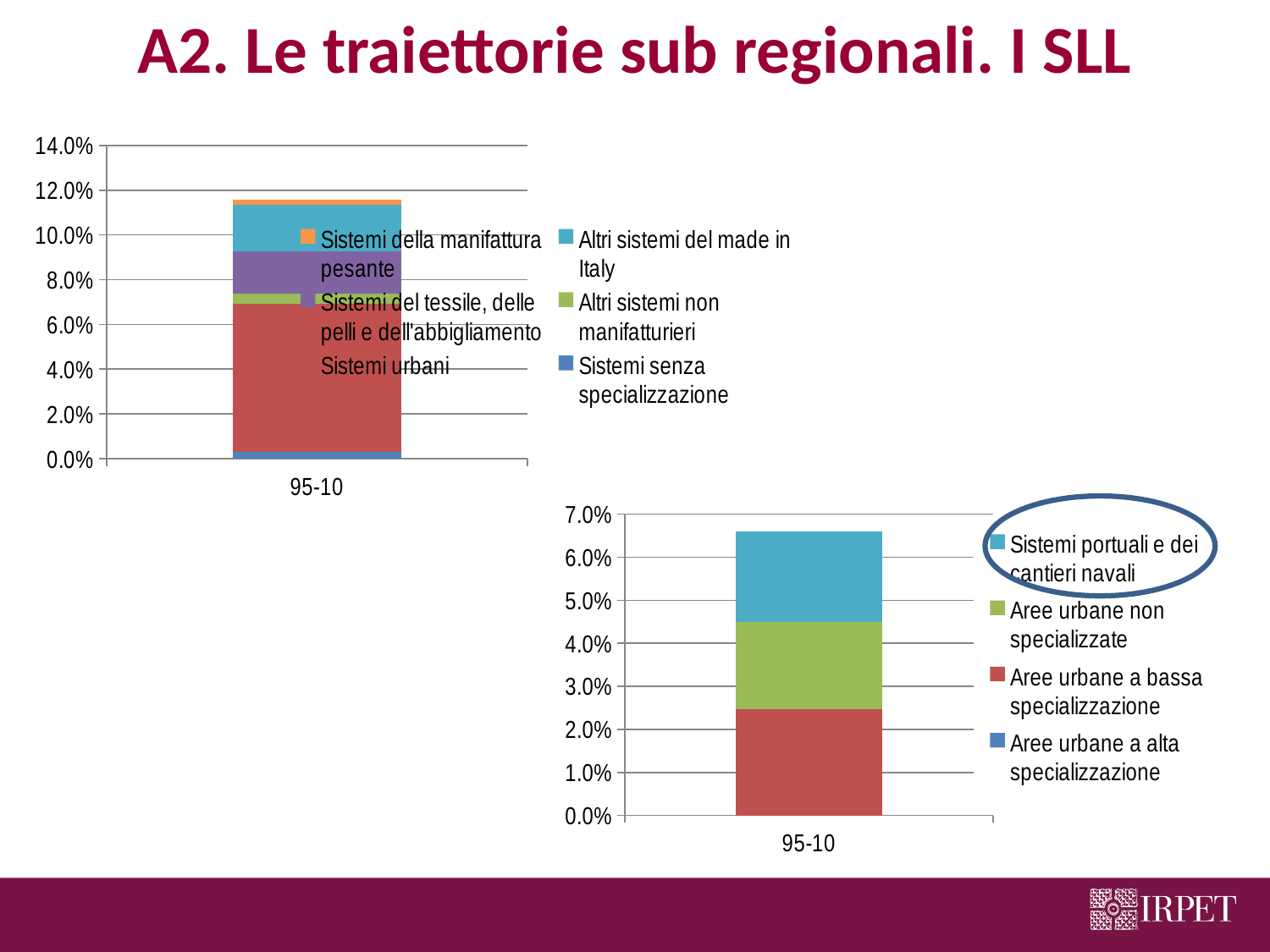
In the bottom-right chart, is the total height of the stacked bar greater or less than 6.0%? greater How many categories are shown on the x axis of the top-left chart? 1 How many series does the legend of the top-left chart list? 6 What kind of chart is the top-left chart on the slide? Stacked bar chart In the top-left chart, is the segment for Sistemi urbani greater or less than 6.0%? greater How many series does the legend of the bottom-right chart list? 4 What is the category label on the x axis of the bottom-right chart? 95-10 What kind of chart is the bottom-right chart on the slide? Stacked bar chart In the top-left chart, which series has the largest segment in the stacked bar? Sistemi urbani Which legend entry in the bottom-right chart is circled? Sistemi portuali e dei cantieri navali In the top-left chart, is the total height of the stacked bar greater or less than 10.0%? greater